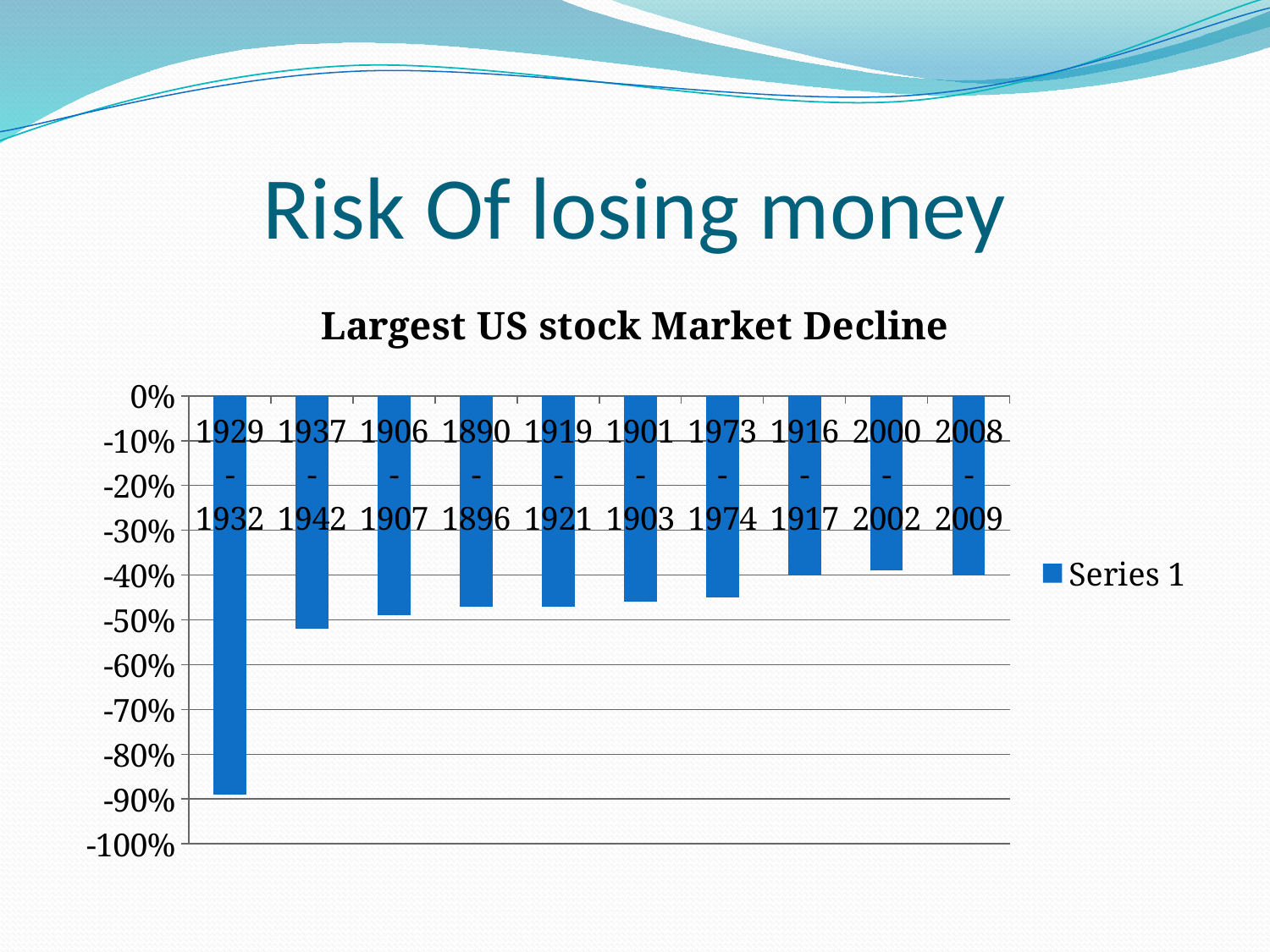
Is the value for 1929-1932 greater or less than -80%? less Which period has the lowest value (the largest decline) in the chart? 1929-1932 Is the value for 2000-2002 greater or less than -50%? greater Is the value for 1973-1974 greater or less than -30%? less Which period shows the larger decline, 1929-1932 or 1937-1942? 1929-1932 What kind of chart is shown on the slide? bar chart How many series does the legend list? 1 How many periods (bars) are plotted in the chart? 10 What is the name of the series shown in the legend? Series 1 What is the title of the chart? Largest US stock Market Decline